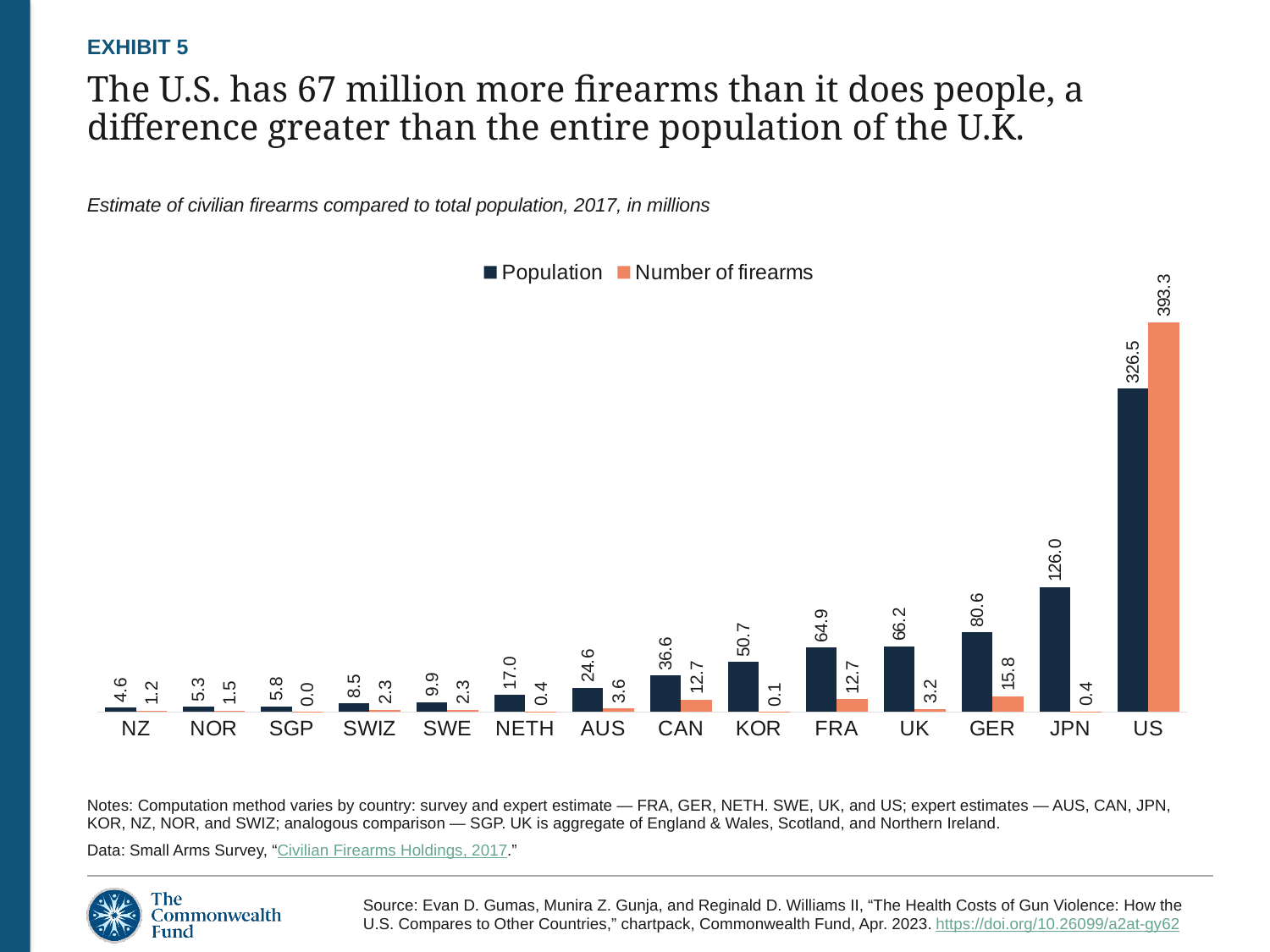
What is the difference between Germany's population and its number of firearms? 64.8 What is the population value shown for Japan (JPN)? 126.0 Which country has the lowest number of firearms? SGP How many series does the legend list? 2 Which country has the lowest population value in the chart? NZ What is the number of firearms shown for Germany (GER)? 15.8 How many countries are shown on the x axis? 14 Do the population values rise or fall moving from left to right along the x axis? rise Which has more firearms, Canada (CAN) or the UK? CAN Which country has the highest number of firearms? US By how much does the number of firearms in the US exceed its population, in millions? 66.8 What is the number of firearms shown for Canada (CAN)? 12.7